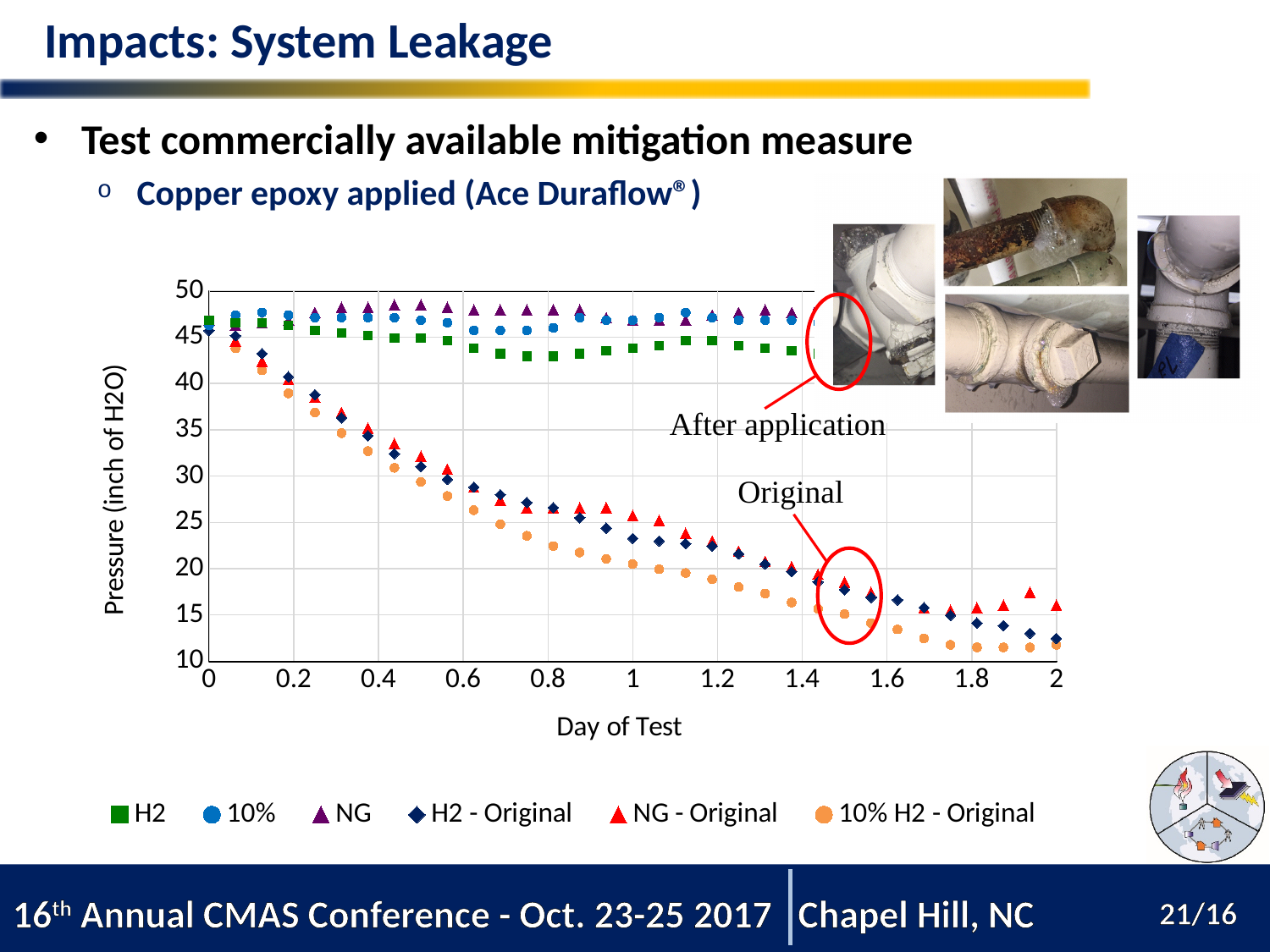
What kind of chart is shown on the slide? scatter chart Which two annotations are written next to the circled groups of points on the chart? After application; Original What is the title of the vertical axis of the chart? Pressure (inch of H2O) How many series does the chart legend list? 6 Is the pressure for H2 - Original at day 2 greater or less than 15? less Does the 10% H2 - Original series rise or fall along the x axis? fall Does the H2 - Original series rise or fall as the day of test increases? fall Is the pressure for H2 - Original at day 0.8 greater or less than 25? greater At day 2 of the test, which series has the higher pressure, NG - Original or H2 - Original? NG - Original At day 1 of the test, which series has the higher pressure, H2 - Original or 10% H2 - Original? H2 - Original Is the pressure for NG at day 1 greater or less than 45? greater At day 1 of the test, which series has the higher pressure, NG or H2? NG